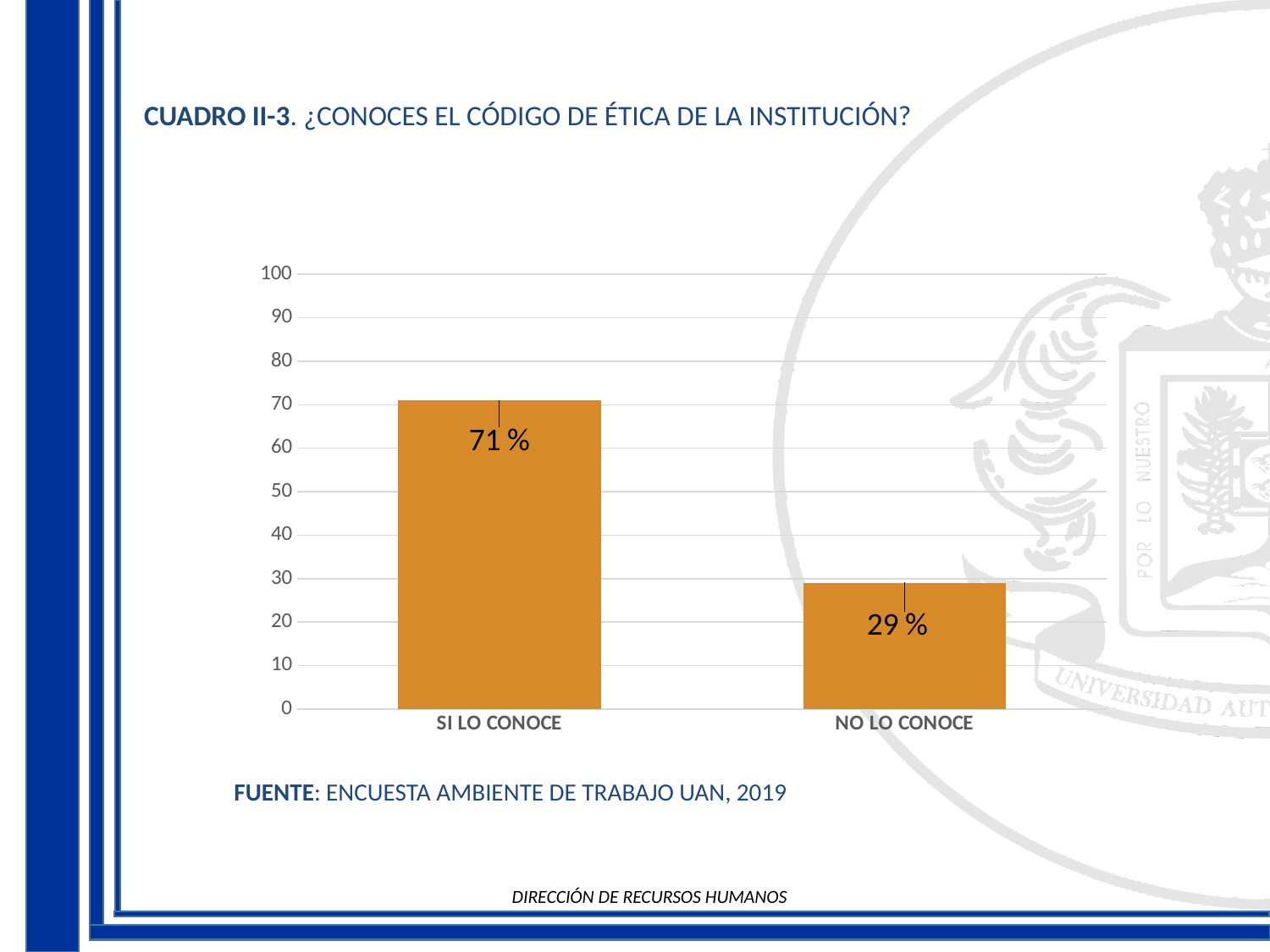
Is the value for SI LO CONOCE greater or less than 60? greater What is the highest value shown on the y axis? 100 Which category has the highest value? SI LO CONOCE What is the difference between the values for SI LO CONOCE and NO LO CONOCE? 42 % Which is larger, the value for SI LO CONOCE or NO LO CONOCE? SI LO CONOCE What is the value for SI LO CONOCE? 71 % Which category has the lowest value? NO LO CONOCE How many categories are shown on the x axis? 2 What is the value for NO LO CONOCE? 29 % Is the value for NO LO CONOCE greater or less than 40? less What source is cited below the chart? ENCUESTA AMBIENTE DE TRABAJO UAN, 2019 What kind of chart is shown on the slide? bar chart